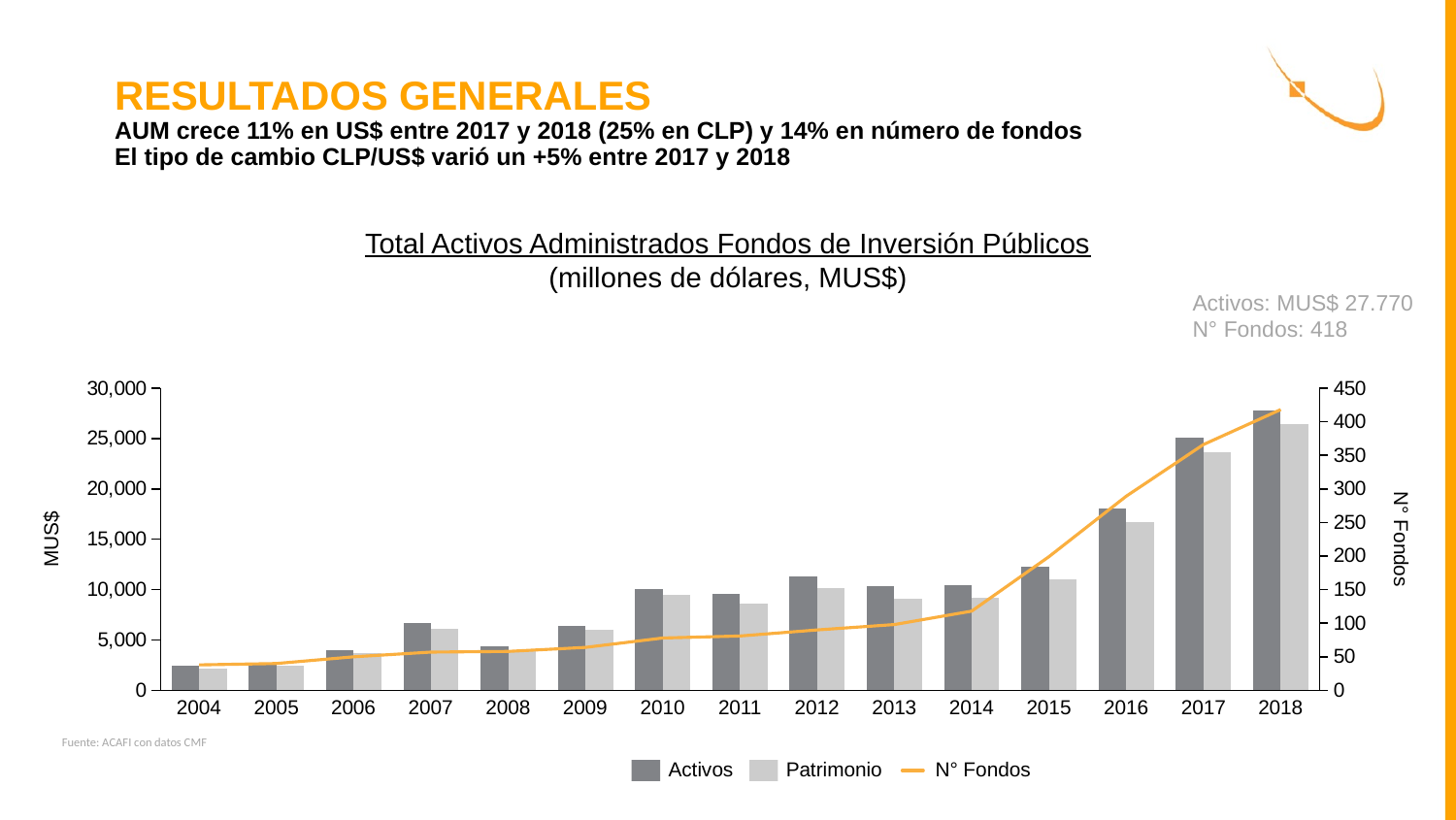
What is the N° Fondos value for 2018 as stated on the slide? 418 In which year is the Activos value highest? 2018 How many years are shown on the x axis of the chart? 15 What kind of chart is this? Bar chart with a line What is the title of the chart? Total Activos Administrados Fondos de Inversión Públicos In which year is the Activos value lowest? 2004 Is the Patrimonio value for 2017 greater or less than 25,000? less Which is larger, the Activos value for 2012 or for 2013? 2012 What is the Activos value for 2018 as stated on the slide? MUS$ 27.770 Do the Activos values generally rise or fall from 2004 to 2018? rise Is the Activos value for 2016 greater or less than 15,000? greater How many series does the chart legend list? 3